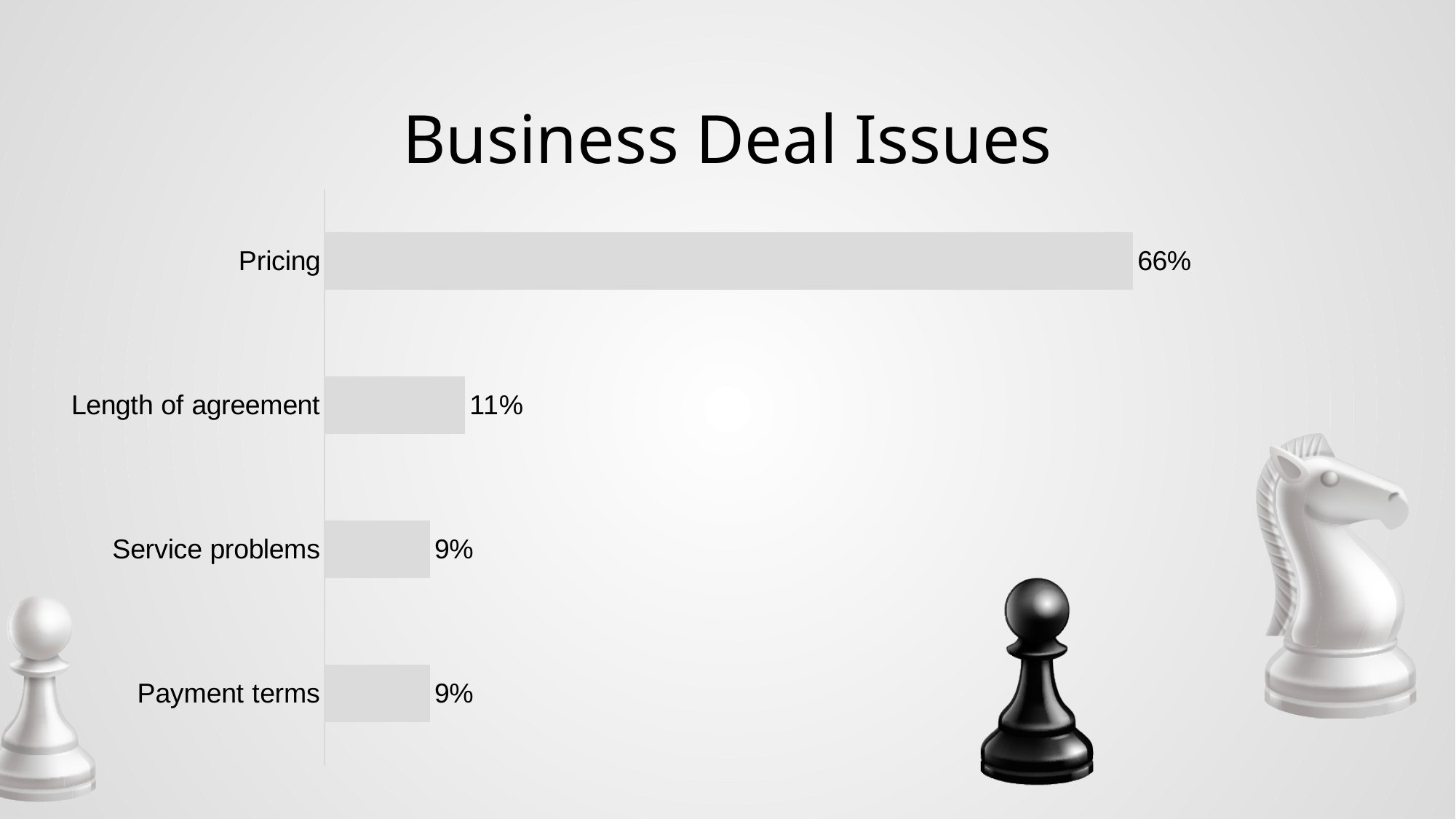
What is the value for Length of agreement? 11% Which category has the highest value? Pricing What is the title of the slide? Business Deal Issues What is the difference between the values for Length of agreement and Service problems? 2% What is the total of the values for Service problems and Payment terms? 18% What is the difference between the values for Pricing and Length of agreement? 55% How many categories are shown in the chart? 4 What is the value for Service problems? 9% What is the value for Pricing? 66% Which is larger, the value for Pricing or the value for Length of agreement? Pricing What is the value for Payment terms? 9% What kind of chart is shown on the slide? Bar chart